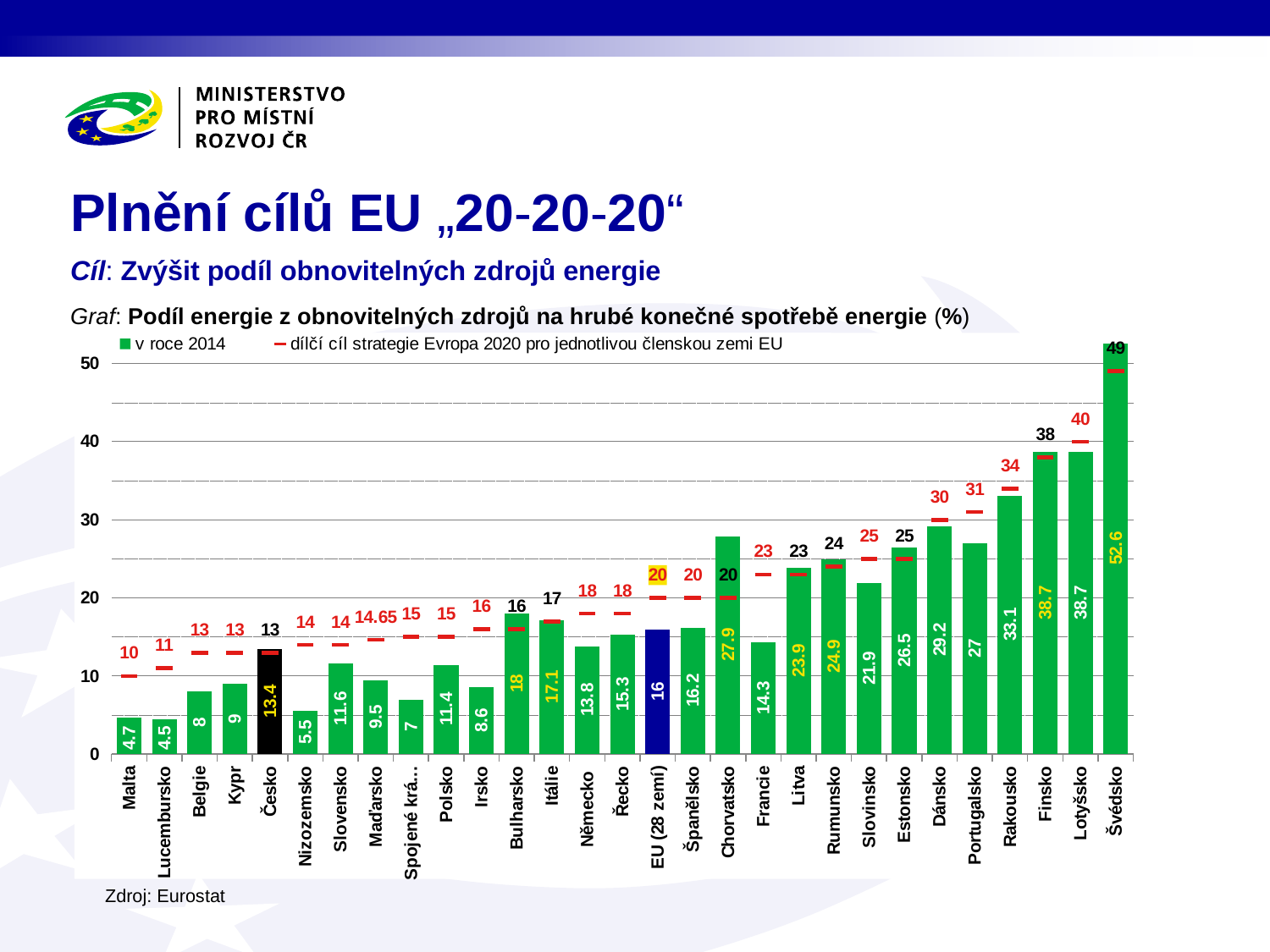
Which country has the highest 2014 value? Švédsko Which country has the lowest 2014 value? Lucembursko Is the 2014 value for Rakousko greater or less than 30? greater What is the 2014 value for EU (28 zemí)? 16 How many series does the legend list? 2 What is the 2014 value for Švédsko? 52.6 How many countries/entities are shown on the x axis? 29 What is the 2014 value for Česko? 13.4 Which has a higher 2014 value, Dánsko or Portugalsko? Dánsko What is the difference between the 2014 value for Chorvatsko and its target of 20? 7.9 What kind of chart is shown on the slide? bar chart What is the Europe 2020 target (dílčí cíl) shown for Francie? 23